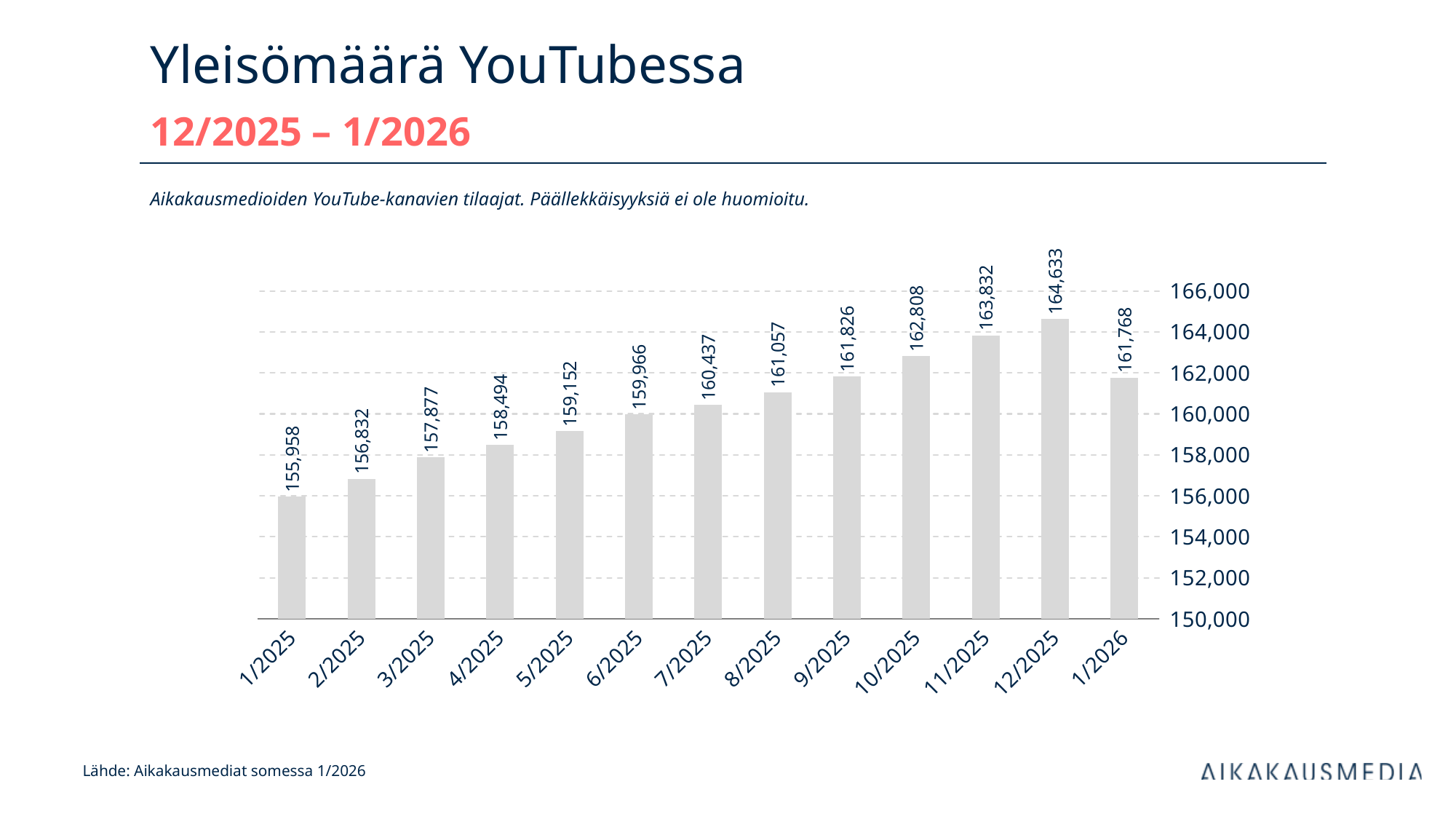
What is the value for 12/2025? 164,633 What is the value for 1/2025? 155,958 What is the difference between the values for 12/2025 and 1/2026? 2,865 Which month has the lowest value? 1/2025 What is the value for 6/2025? 159,966 What is the value for 1/2026? 161,768 What kind of chart is shown on the slide? bar chart What is the difference between the values for 1/2025 and 12/2025? 8,675 Is the value for 4/2025 greater or less than 160,000? less How many months are shown on the x axis? 13 Which is larger, the value for 9/2025 or the value for 1/2026? 9/2025 Which month has the highest value? 12/2025